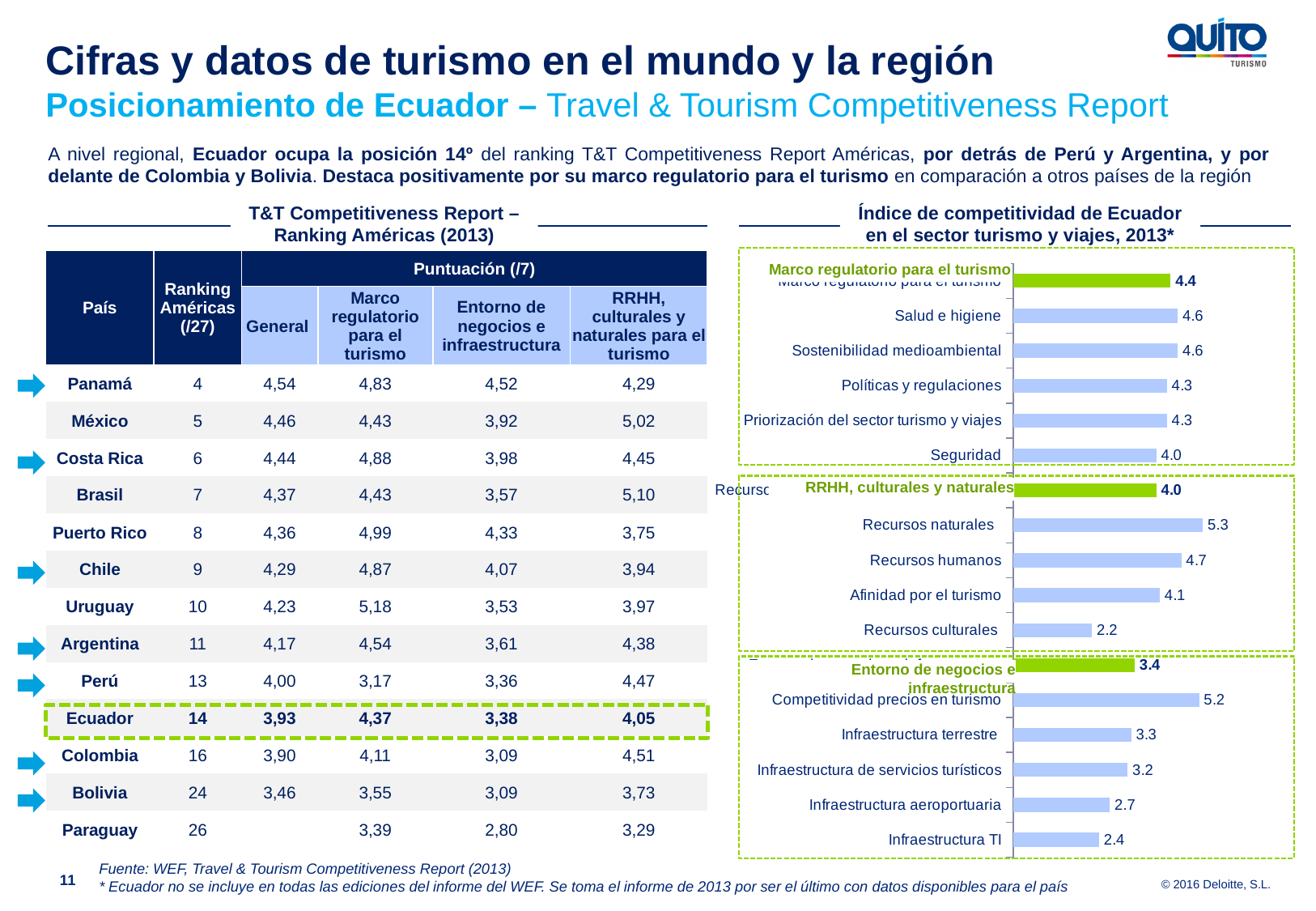
In the chart 'Índice de competitividad de Ecuador en el sector turismo y viajes, 2013*', which category has the lowest value? Recursos culturales In the chart 'Índice de competitividad de Ecuador en el sector turismo y viajes, 2013*', what is the difference between the values for Competitividad precios en turismo and Infraestructura aeroportuaria? 2.5 In the chart 'Índice de competitividad de Ecuador en el sector turismo y viajes, 2013*', what is the value for Marco regulatorio para el turismo? 4.4 In the chart 'Índice de competitividad de Ecuador en el sector turismo y viajes, 2013*', which is larger: the value for Salud e higiene or the value for Seguridad? Salud e higiene In the chart 'Índice de competitividad de Ecuador en el sector turismo y viajes, 2013*', what is the value for Entorno de negocios e infraestructura? 3.4 In the chart 'Índice de competitividad de Ecuador en el sector turismo y viajes, 2013*', what is the value for Recursos naturales? 5.3 In the chart 'Índice de competitividad de Ecuador en el sector turismo y viajes, 2013*', how many bars are coloured green rather than light blue? 3 What kind of chart is shown on the right side of the slide under the title 'Índice de competitividad de Ecuador en el sector turismo y viajes, 2013*'? Bar chart In the chart 'Índice de competitividad de Ecuador en el sector turismo y viajes, 2013*', what is the difference between the values for Recursos naturales and Recursos culturales? 3.1 In the chart 'Índice de competitividad de Ecuador en el sector turismo y viajes, 2013*', which category has the highest value? Recursos naturales How many bars are plotted in the chart 'Índice de competitividad de Ecuador en el sector turismo y viajes, 2013*'? 17 In the chart 'Índice de competitividad de Ecuador en el sector turismo y viajes, 2013*', what is the value for Infraestructura TI? 2.4